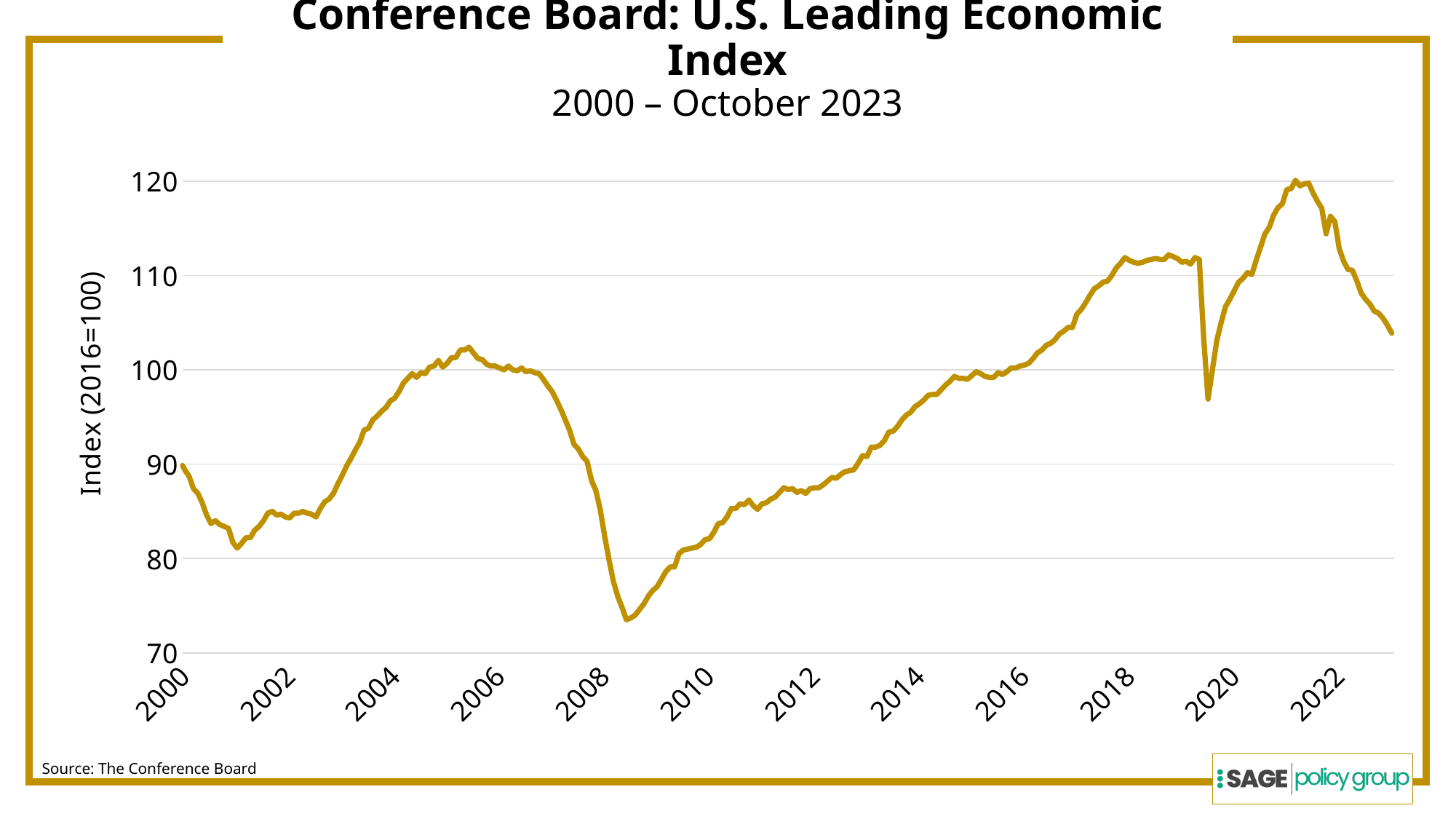
How many year labels are shown on the x axis? 12 How many lines are plotted on the chart? 1 What kind of chart is shown on the slide? Line chart Is the value of the index at its lowest point around 2009 greater or less than 80? less Does the index rise or fall between 2009 and 2018? Rise Is the value of the index at the end of the series (October 2023) greater or less than 100? greater Does the index rise or fall from 2022 to October 2023? Fall What is the title of the chart? Conference Board: U.S. Leading Economic Index What does the y-axis label say? Index (2016=100) Is the value of the index at the sharp dip in 2020 greater or less than 100? less